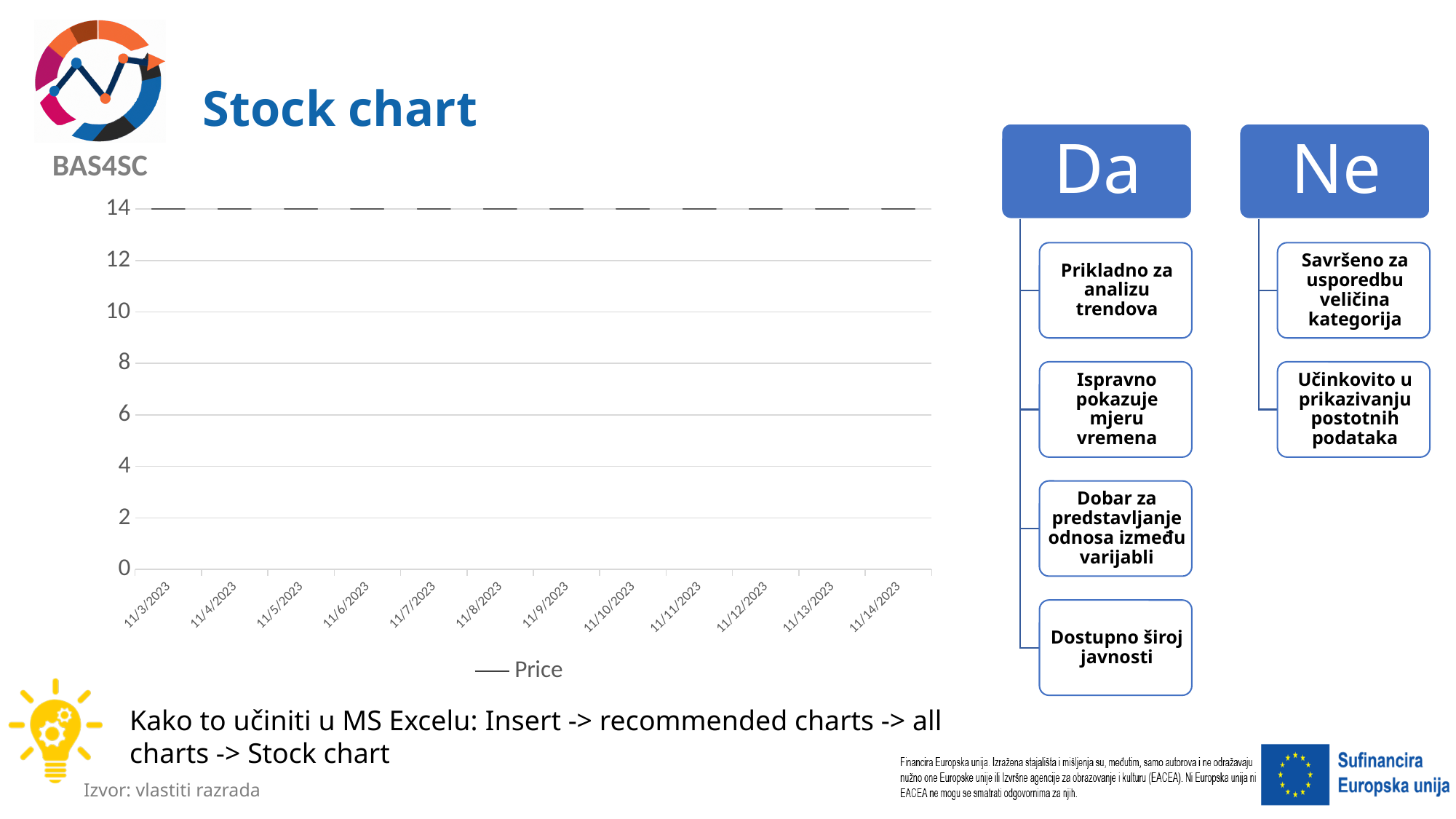
What is the highest value shown on the y axis? 14 What is the title of the slide containing the chart? Stock chart Do the Price values rise, fall or stay flat from 11/3/2023 to 11/14/2023? stay flat Is the Price value for 11/3/2023 greater or less than 10? greater What is the name of the series shown in the chart legend? Price How many dates are shown on the x axis of the chart? 12 What kind of chart is shown on the slide? stock chart What value does the Price marker for 11/8/2023 land on? 14 Is the Price value for 11/14/2023 greater or less than 12? greater What is the first date shown on the x axis? 11/3/2023 How many series does the chart legend list? 1 What is the last date shown on the x axis? 11/14/2023